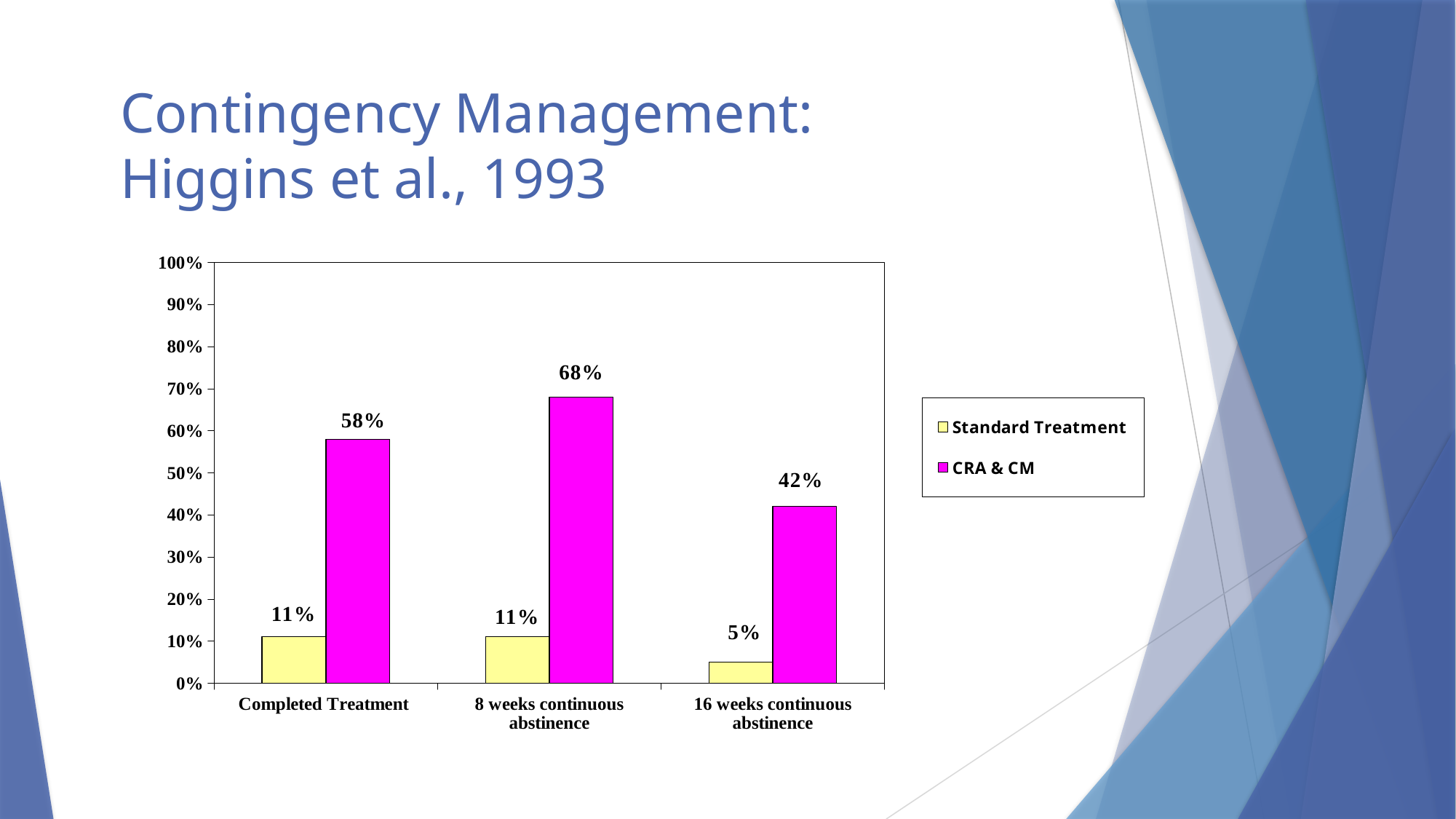
What is the value for CRA & CM in the Completed Treatment category? 58% Which category has the lowest value for Standard Treatment? 16 weeks continuous abstinence What is the value for Standard Treatment in the 16 weeks continuous abstinence category? 5% Which is larger in the Completed Treatment category, Standard Treatment or CRA & CM? CRA & CM Which category has the highest value for CRA & CM? 8 weeks continuous abstinence Is the value for CRA & CM in the 16 weeks continuous abstinence category greater or less than 50%? less How many categories are shown on the x axis? 3 What colour are the CRA & CM bars? magenta What is the value for CRA & CM in the 8 weeks continuous abstinence category? 68% What kind of chart is shown on the slide? bar chart What is the difference between CRA & CM and Standard Treatment in the 16 weeks continuous abstinence category? 37% How many series does the legend list? 2